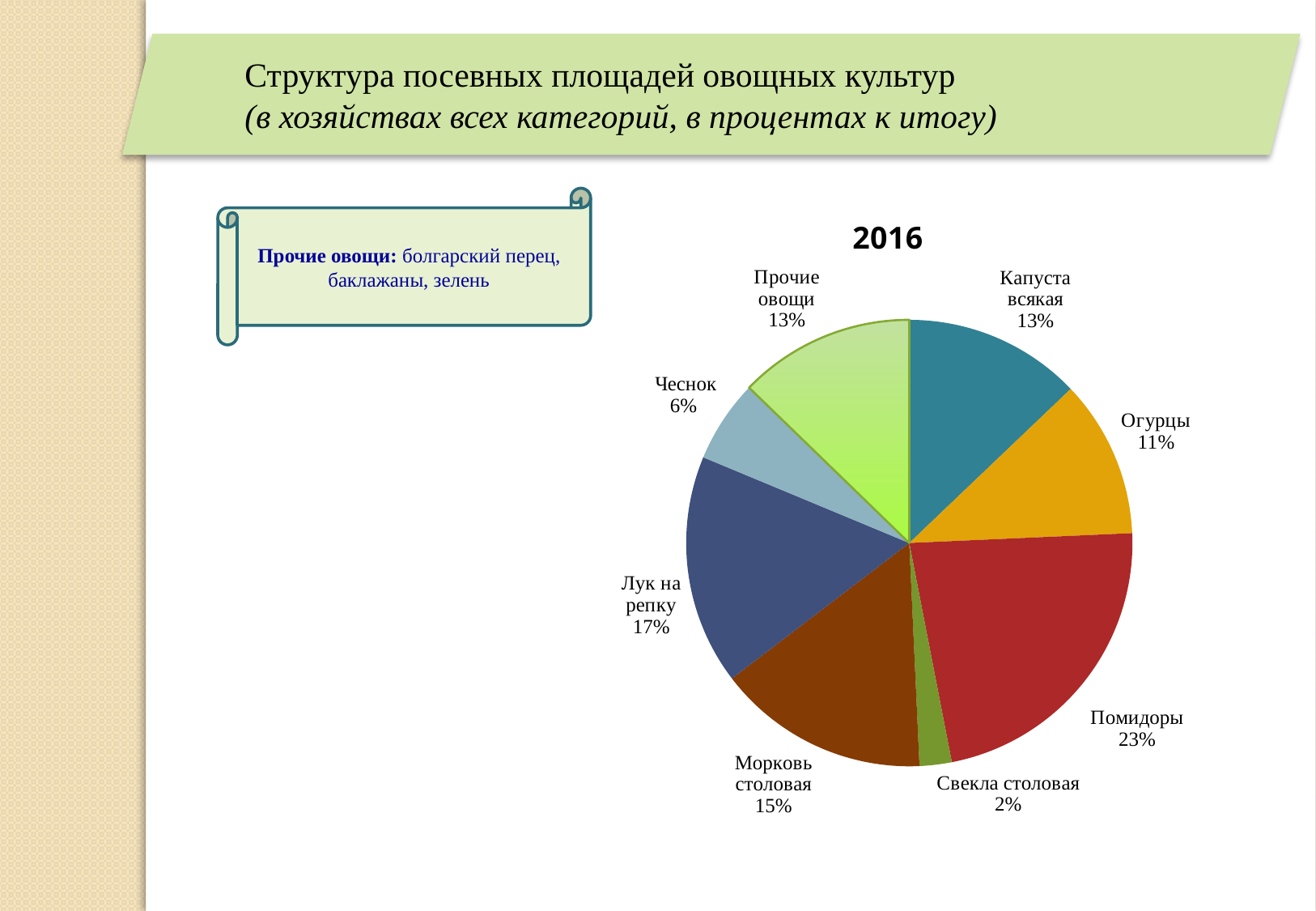
Which is larger, the share of Огурцы or the share of Лук на репку? Лук на репку What is the value for Лук на репку? 17% What kind of chart is shown on the slide? pie chart What is the value for Чеснок? 6% How many categories are shown in the pie chart? 8 Which category has the smallest slice of the pie? Свекла столовая What is the title of the chart? 2016 What is the difference between the shares of Помидоры and Морковь столовая? 8% Which category has the largest slice of the pie? Помидоры What is the value for Свекла столовая? 2% What share of the pie does Помидоры have? 23% What is the combined share of Капуста всякая and Прочие овощи? 26%